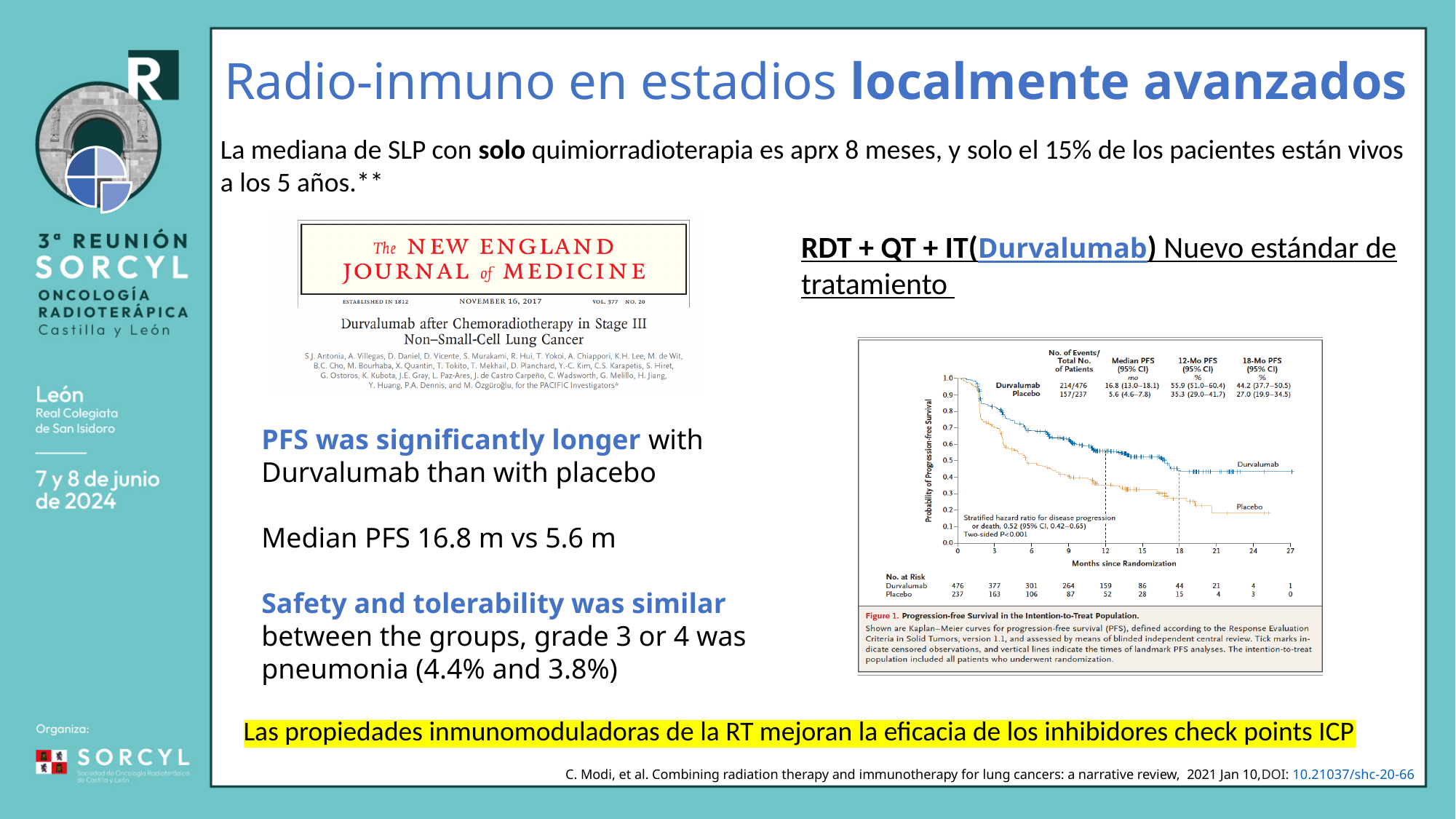
Which curve lies higher over time, Durvalumab or Placebo? Durvalumab What is the difference in median PFS between Durvalumab (16.8 mo) and Placebo (5.6 mo)? 11.2 mo What kind of chart is shown on the slide? Line chart (Kaplan-Meier survival curves) What is the 18-month PFS percentage for the Placebo group? 27.0% How many patients were at risk in the Durvalumab group at 0 months? 476 What is the 12-month PFS percentage for the Durvalumab group? 55.9% Is the Placebo curve at 12 months greater or less than 0.5? less What is the median PFS for the Placebo group according to the chart's table? 5.6 mo How many series (treatment groups) are plotted in the progression-free survival chart? 2 Do the probability of progression-free survival curves rise or fall as months since randomization increase? Fall What are the two groups plotted in the progression-free survival chart? Durvalumab and Placebo What is the median PFS for the Durvalumab group according to the chart's table? 16.8 mo